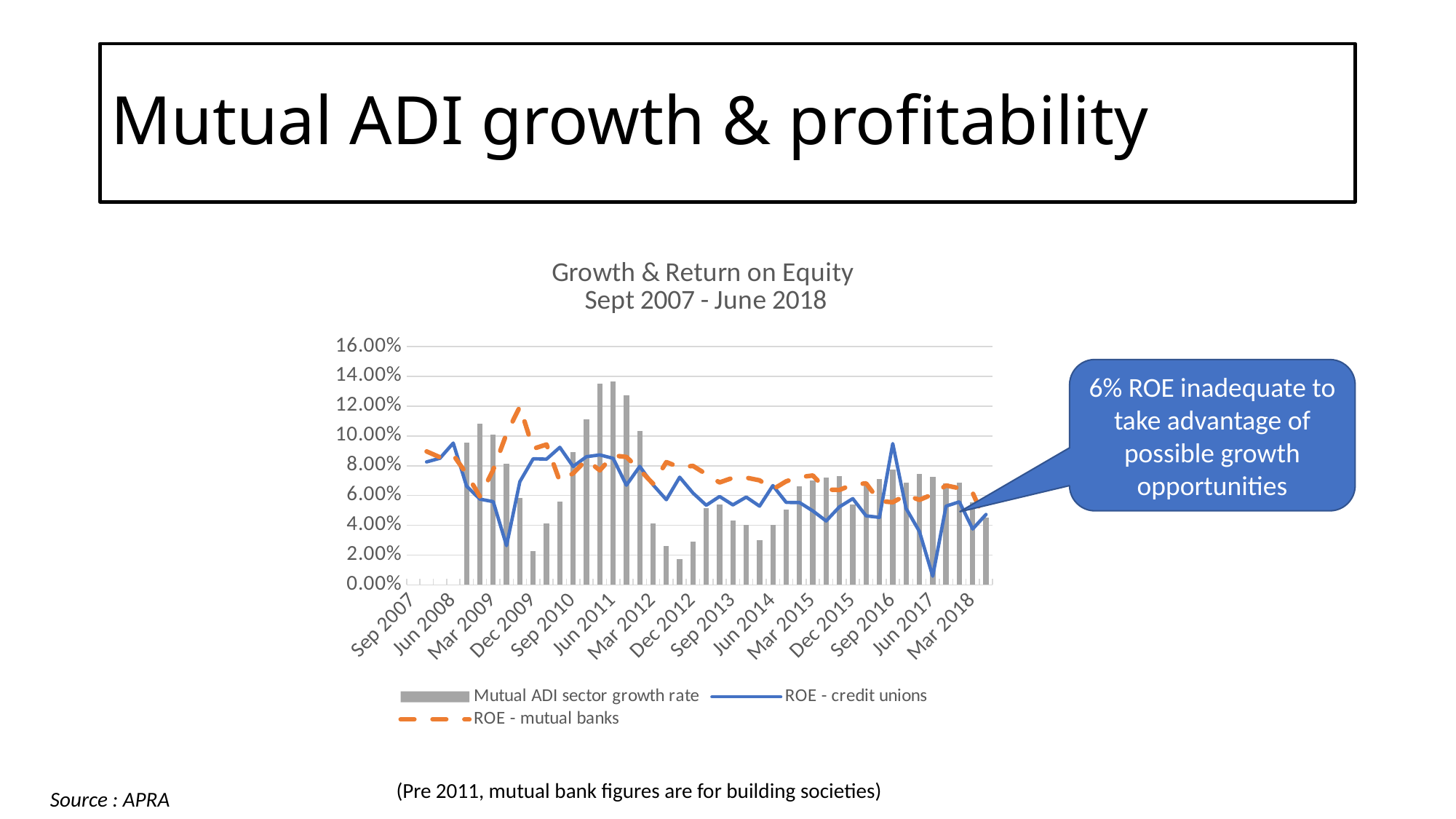
Around Dec 2009, which is higher: ROE - mutual banks or ROE - credit unions? ROE - mutual banks Which series reaches the lowest value anywhere on the chart? ROE - credit unions Is the highest Mutual ADI sector growth rate bar, around Jun 2011, greater or less than 12.00%? greater What kind of chart is the Growth & Return on Equity chart? Combination bar and line chart Is the peak of the ROE - mutual banks line, around Dec 2009, greater or less than 10.00%? greater Which series in the chart is drawn as grey bars? Mutual ADI sector growth rate How many date labels are shown on the x axis of the chart? 15 Is the ROE - credit unions spike around Sep 2016 greater or less than 8.00%? greater Which series reaches the highest value anywhere on the chart? Mutual ADI sector growth rate Which series in the chart is drawn as an orange dashed line? ROE - mutual banks How many series does the legend of the Growth & Return on Equity chart list? 3